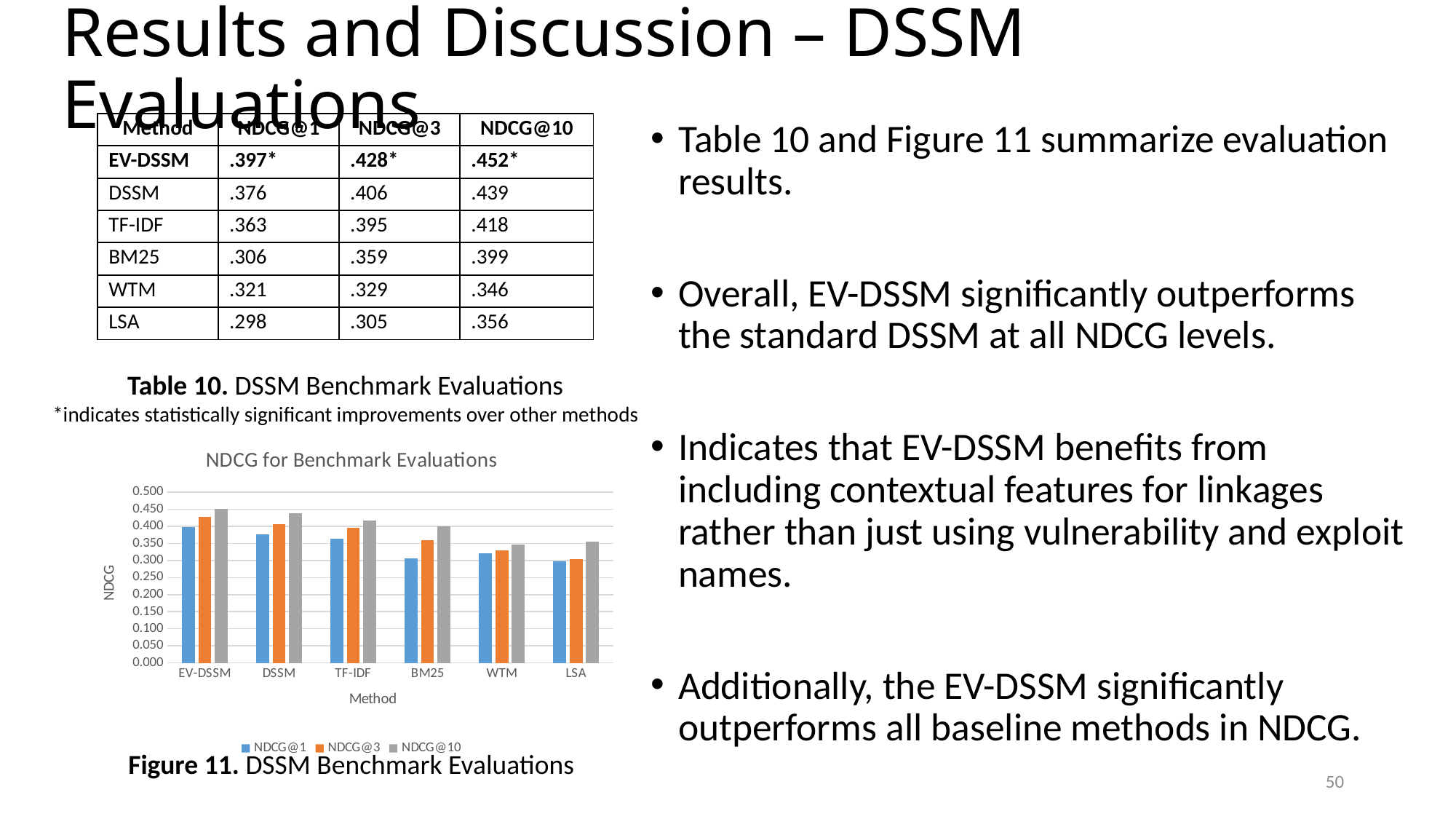
In the 'NDCG for Benchmark Evaluations' chart, is the NDCG@1 value for BM25 greater or less than 0.350? less In the 'NDCG for Benchmark Evaluations' chart, which is larger: the NDCG@1 bar for EV-DSSM or the NDCG@1 bar for BM25? EV-DSSM How many methods are shown on the x axis of the 'NDCG for Benchmark Evaluations' chart? 6 According to Table 10 and the 'NDCG for Benchmark Evaluations' chart, what is the NDCG@10 value for DSSM? .439 In the 'NDCG for Benchmark Evaluations' chart, which method has the highest NDCG@1 bar? EV-DSSM How many series does the legend of the 'NDCG for Benchmark Evaluations' chart list? 3 According to Table 10 and the 'NDCG for Benchmark Evaluations' chart, what is the NDCG@3 value for WTM? .329 What is the label on the y axis of the 'NDCG for Benchmark Evaluations' chart? NDCG Using the values in Table 10, what is the difference between the NDCG@10 values of EV-DSSM and DSSM? .013 In the 'NDCG for Benchmark Evaluations' chart, is the NDCG@10 value for EV-DSSM greater or less than 0.400? greater What kind of chart is Figure 11, 'NDCG for Benchmark Evaluations'? bar chart In the 'NDCG for Benchmark Evaluations' chart, which method has the highest NDCG@10 bar? EV-DSSM